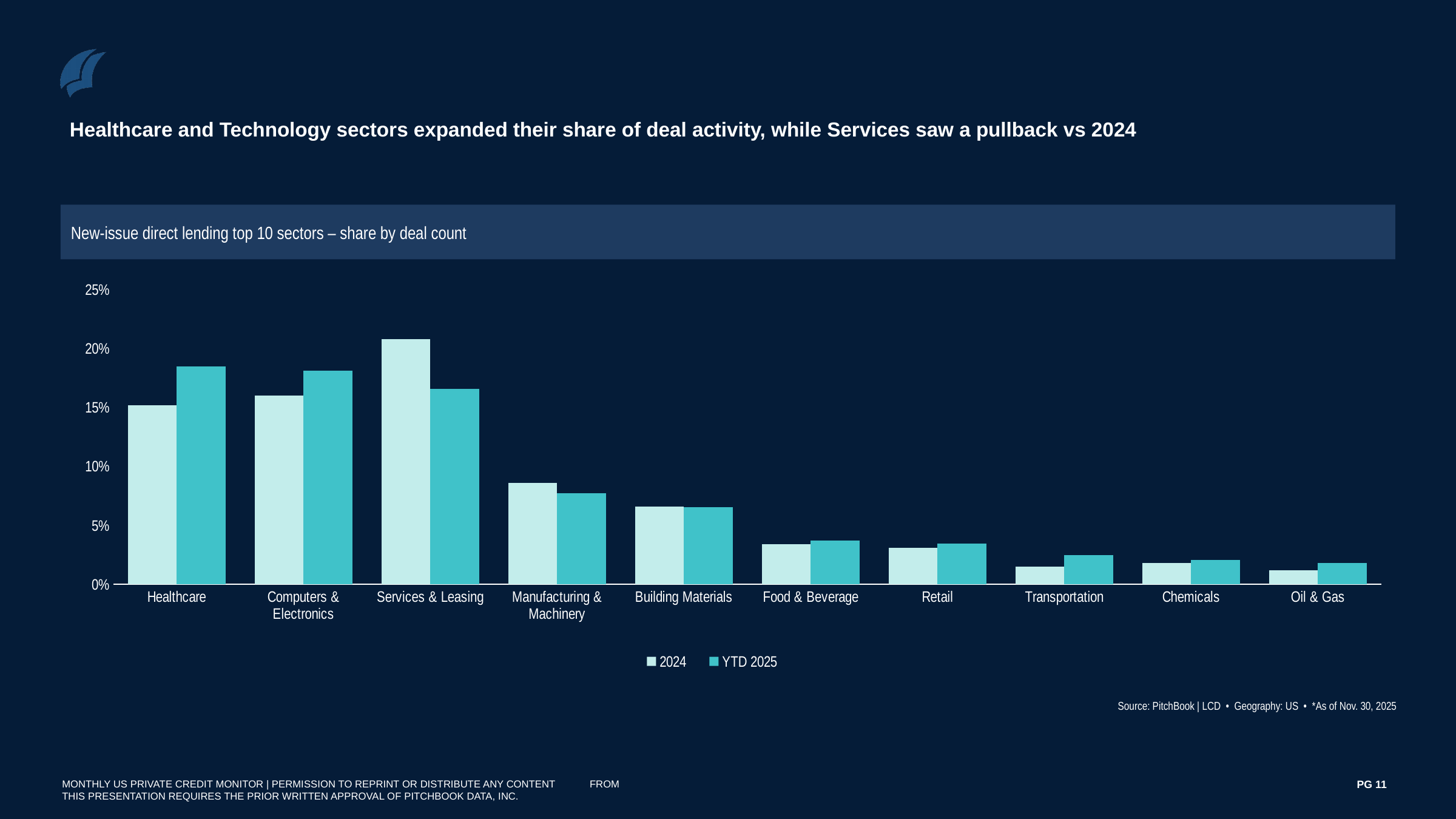
What are the two series named in the legend? 2024 and YTD 2025 Do the 2024 values generally rise or fall moving from left to right along the x axis? fall Is the 2024 value for Services & Leasing greater or less than 20%? greater How many sectors are shown on the x axis? 10 Which sector has the highest 2024 share by deal count? Services & Leasing For Services & Leasing, which is larger: the 2024 share or the YTD 2025 share? 2024 How many series does the legend list? 2 Is the YTD 2025 value for Building Materials greater or less than 5%? greater For Manufacturing & Machinery, which is larger: the 2024 share or the YTD 2025 share? 2024 Is the 2024 value for Manufacturing & Machinery greater or less than 10%? less For Healthcare, which is larger: the 2024 share or the YTD 2025 share? YTD 2025 What kind of chart is shown on the slide? bar chart